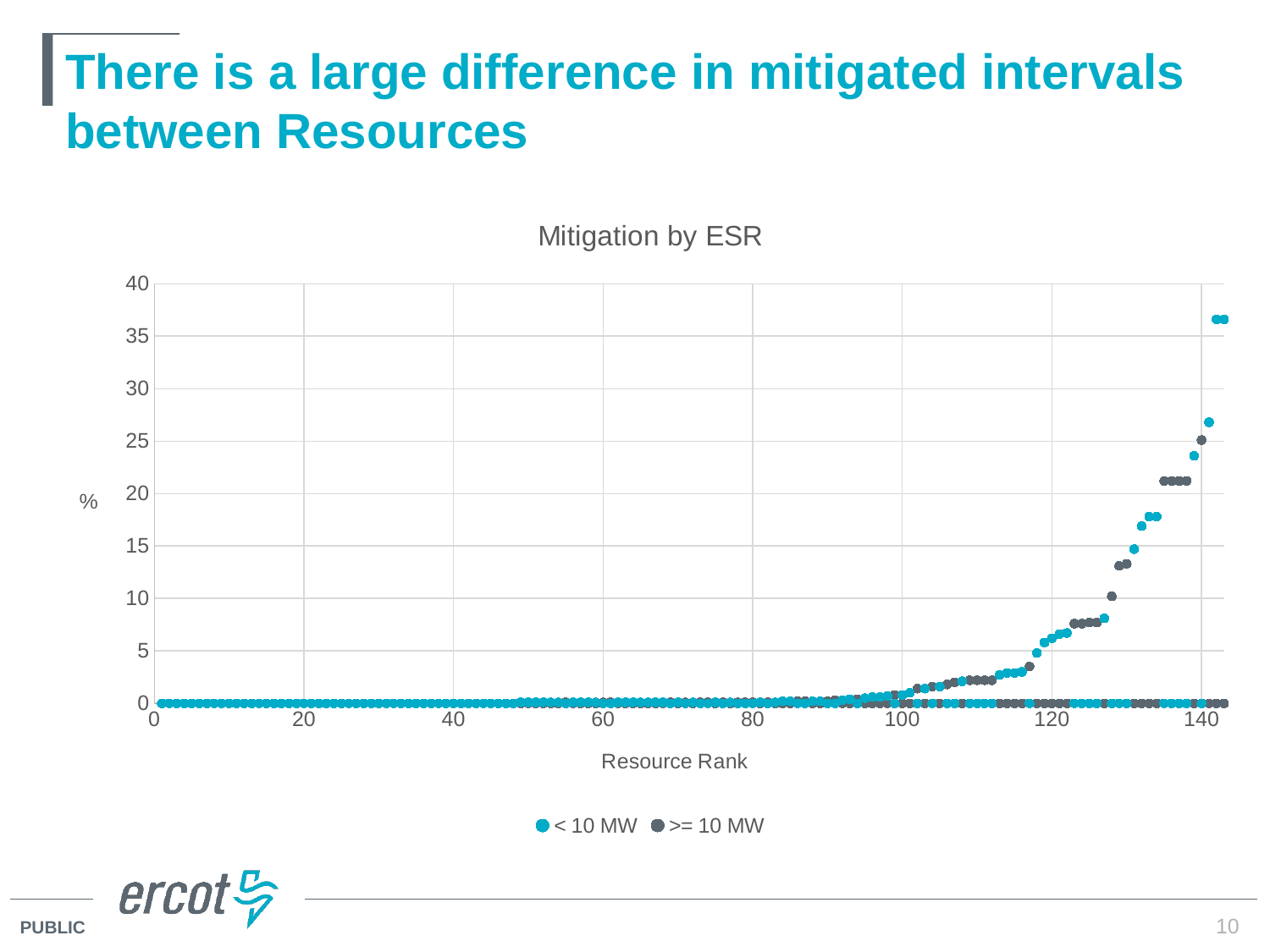
What is the label of the y axis? % What is the maximum value shown on the x axis? 140 What kind of chart is shown on the slide? scatter chart What is the maximum value shown on the y axis? 40 Which series reaches the highest value on the chart, < 10 MW or >= 10 MW? < 10 MW How many series does the chart's legend list? 2 What is the label of the x axis? Resource Rank Do the plotted values rise or fall as Resource Rank increases along the x axis? rise Is the highest plotted value for the >= 10 MW series greater or less than 30? less What is the title of the chart? Mitigation by ESR Is the highest plotted value for the < 10 MW series greater or less than 35? greater What are the two series named in the legend? < 10 MW and >= 10 MW